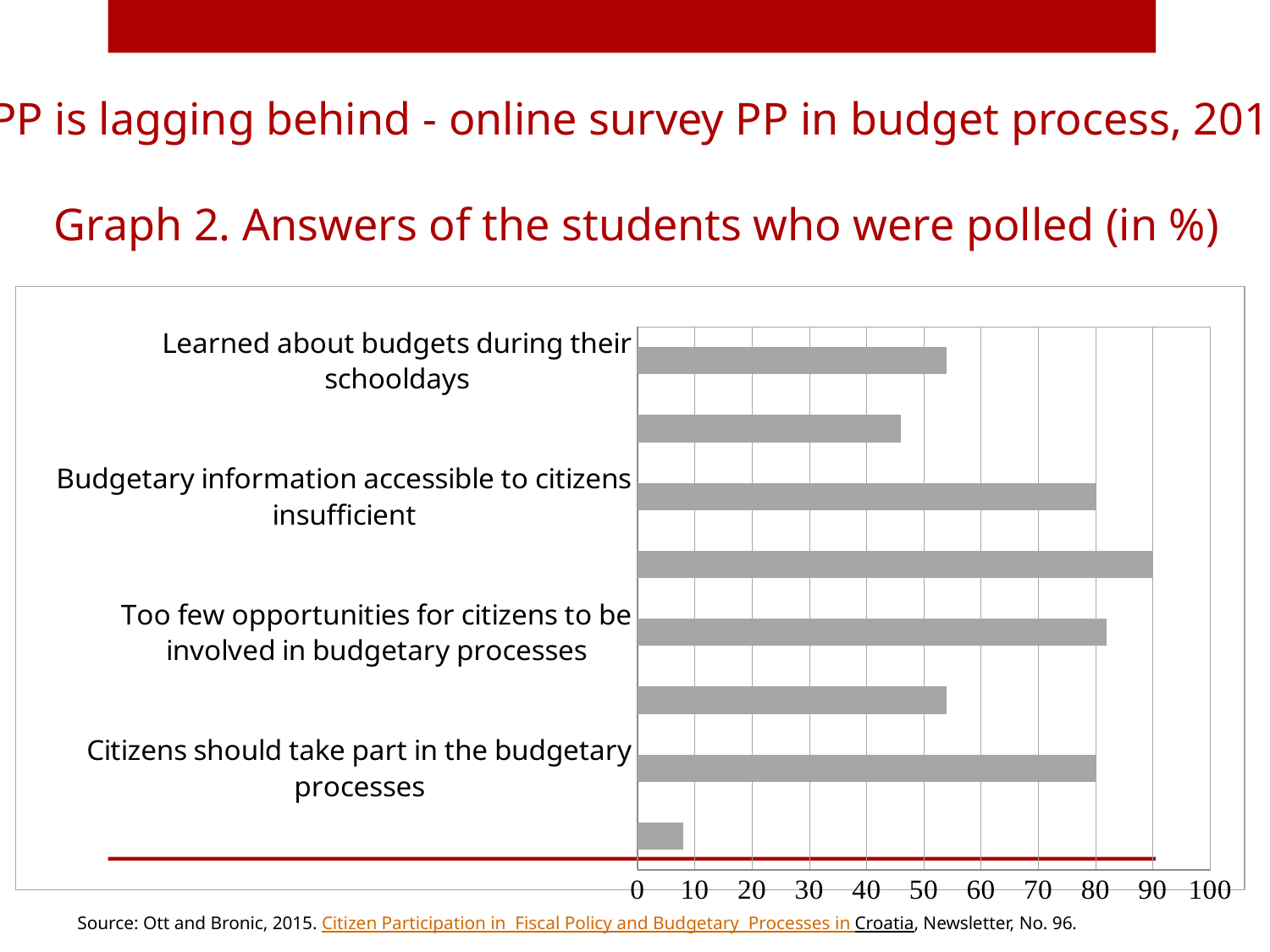
Which is larger: the value for 'Learned about budgets during their schooldays' or the value for 'Budgetary information accessible to citizens insufficient'? Budgetary information accessible to citizens insufficient How many bars are plotted in the chart? 8 Is the value for 'Learned about budgets during their schooldays' greater or less than 60? less What kind of chart is shown on the slide? bar chart Is the value for 'Too few opportunities for citizens to be involved in budgetary processes' greater or less than 70? greater What is the value for 'Budgetary information accessible to citizens insufficient'? 80 Is the value for 'Learned about budgets during their schooldays' greater or less than 50? greater Which is larger: the value for 'Too few opportunities for citizens to be involved in budgetary processes' or the value for 'Learned about budgets during their schooldays'? Too few opportunities for citizens to be involved in budgetary processes What is the maximum value shown on the horizontal axis of the chart? 100 What is the title of the graph on the slide? Graph 2. Answers of the students who were polled (in %) What is the value for 'Citizens should take part in the budgetary processes'? 80